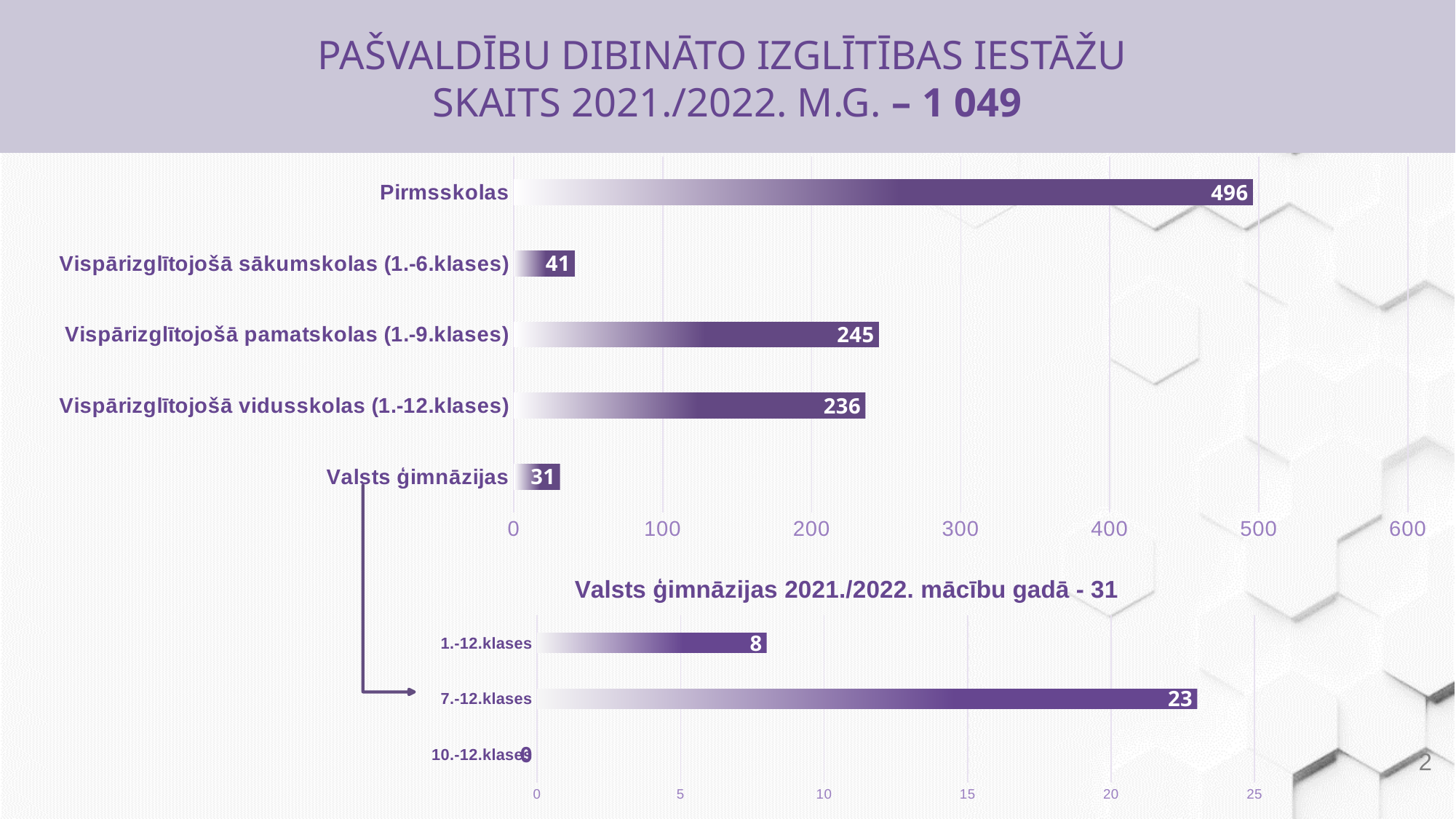
What type of chart is the upper chart? Bar chart In the upper chart, what is the difference between Vispārizglītojošā pamatskolas (1.-9.klases) and Vispārizglītojošā vidusskolas (1.-12.klases)? 9 In the chart titled 'Valsts ģimnāzijas 2021./2022. mācību gadā - 31', which category has the highest value? 7.-12.klases In the upper chart, which category has the lowest value? Valsts ģimnāzijas In the chart titled 'Valsts ģimnāzijas 2021./2022. mācību gadā - 31', what is the difference between 7.-12.klases and 1.-12.klases? 15 In the chart titled 'Valsts ģimnāzijas 2021./2022. mācību gadā - 31', what is the value for 1.-12.klases? 8 In the upper chart, which is larger: Vispārizglītojošā sākumskolas (1.-6.klases) or Valsts ģimnāzijas? Vispārizglītojošā sākumskolas (1.-6.klases) In the chart titled 'Valsts ģimnāzijas 2021./2022. mācību gadā - 31', what is the value for 7.-12.klases? 23 In the upper chart, what is the value for Pirmsskolas? 496 In the upper chart, how many categories are shown? 5 In the upper chart, which category has the highest value? Pirmsskolas In the upper chart, what is the value for Vispārizglītojošā pamatskolas (1.-9.klases)? 245